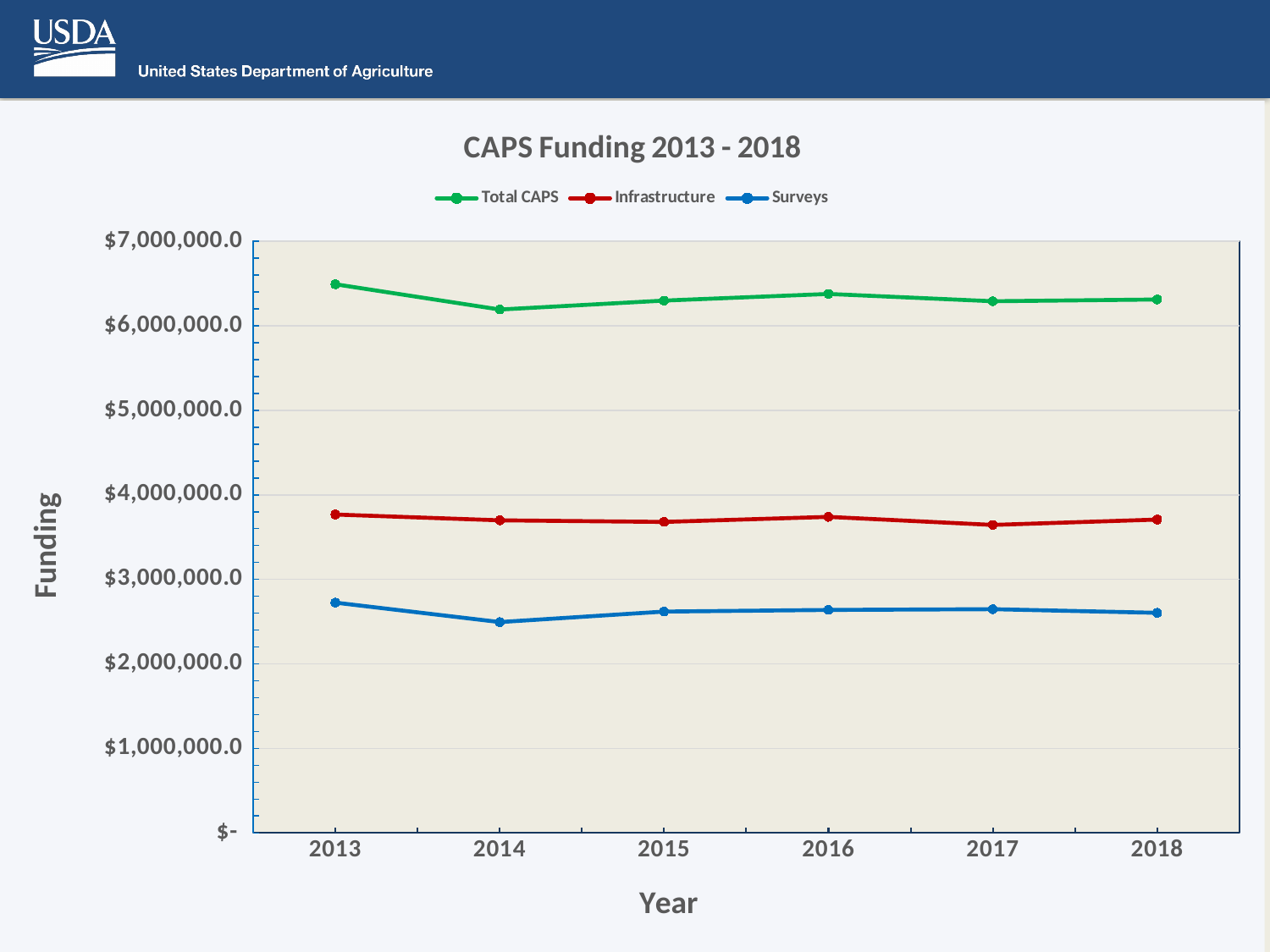
In which year is Total CAPS funding highest? 2013 How many series does the legend list? 3 In which year is Surveys funding lowest? 2014 Is the Infrastructure value for 2016 greater or less than $4,000,000.0? less Is the Surveys value for 2014 greater or less than $3,000,000.0? less Which series has the larger value in 2015, Infrastructure or Surveys? Infrastructure In which year is Total CAPS funding lowest? 2014 What is the title of the chart? CAPS Funding 2013 - 2018 What kind of chart is shown on the slide? line chart Is the Total CAPS value for 2013 greater or less than $6,000,000.0? greater How many years are plotted along the x axis? 6 In which year is Surveys funding highest? 2013